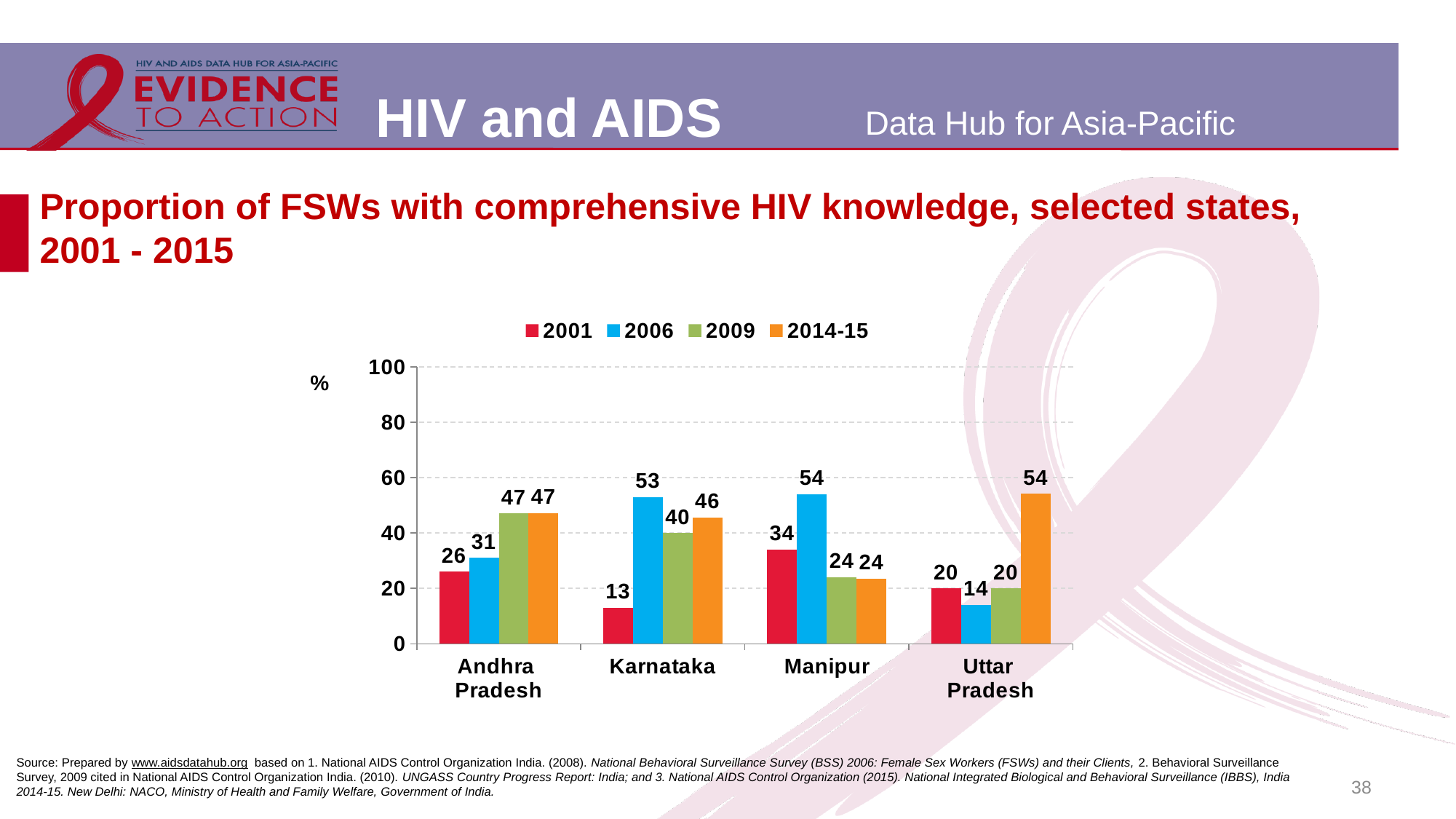
Which is larger for Andhra Pradesh: the 2001 value or the 2006 value? 2006 Which state has the highest value in 2001? Manipur What is the difference between the 2014-15 and 2001 values for Uttar Pradesh? 34 What type of chart is shown on the slide? bar chart What is the value for Manipur in 2001? 34 What is the value for Karnataka in 2006? 53 How many series does the legend list? 4 What is the value for Uttar Pradesh in 2014-15? 54 Which series is shown in orange in the legend? 2014-15 Is the value for Manipur in 2006 greater or less than 40? greater Which state has the lowest value in 2001? Karnataka How many states are shown on the x axis? 4